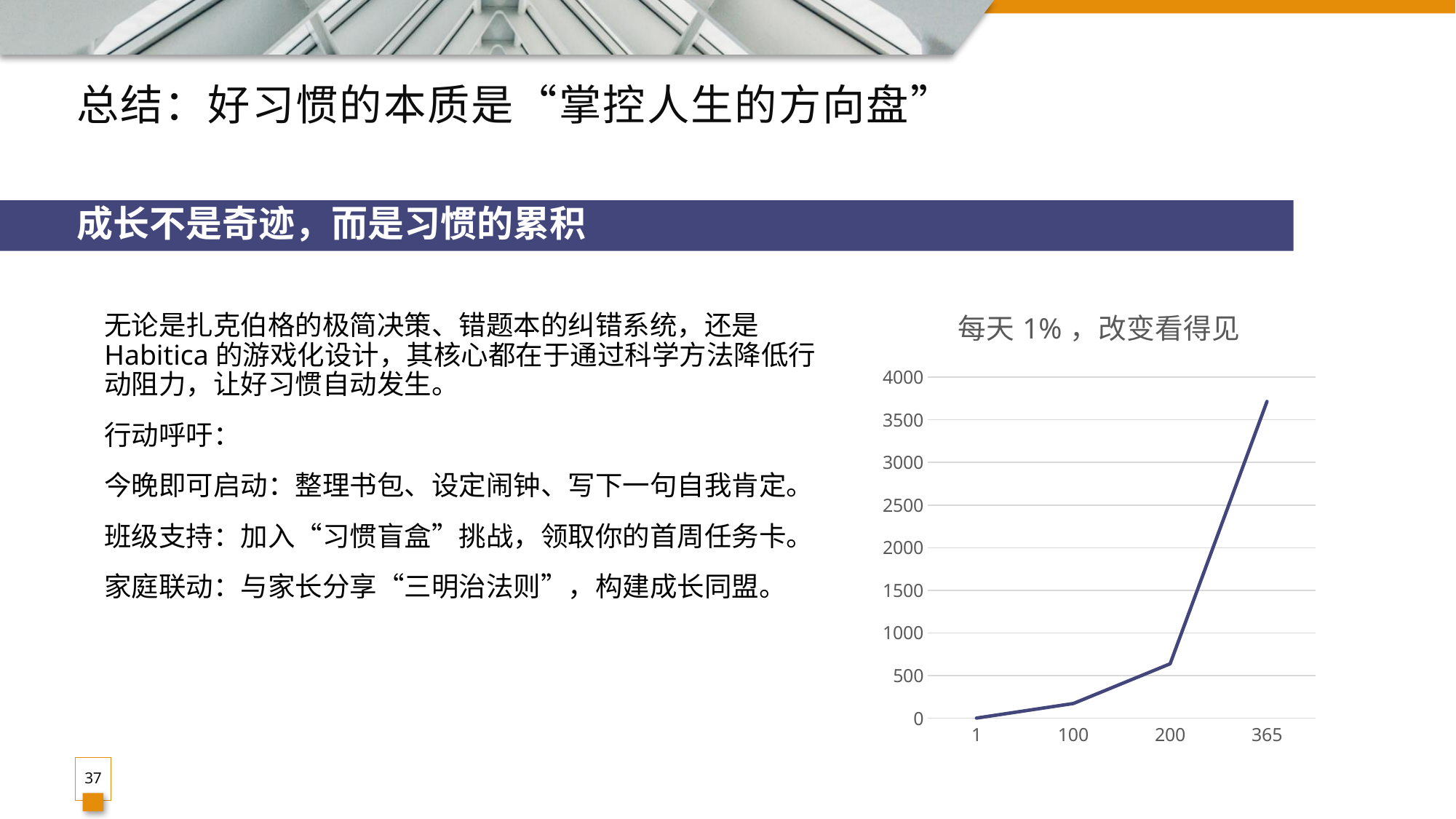
Is the value at 365 greater or less than 4000? less Which x-axis category has the lowest value? 1 What is the title of the chart? 每天 1%，改变看得见 Is the value at 100 greater or less than 500? less Which x-axis category has the highest value? 365 How many points are plotted on the line? 4 What is the highest tick shown on the y axis? 4000 Is the value at 200 greater or less than 1000? less Which is larger, the value at 200 or the value at 100? 200 What kind of chart is shown on the slide? line chart Do the values rise or fall as you move along the x axis from 1 to 365? rise